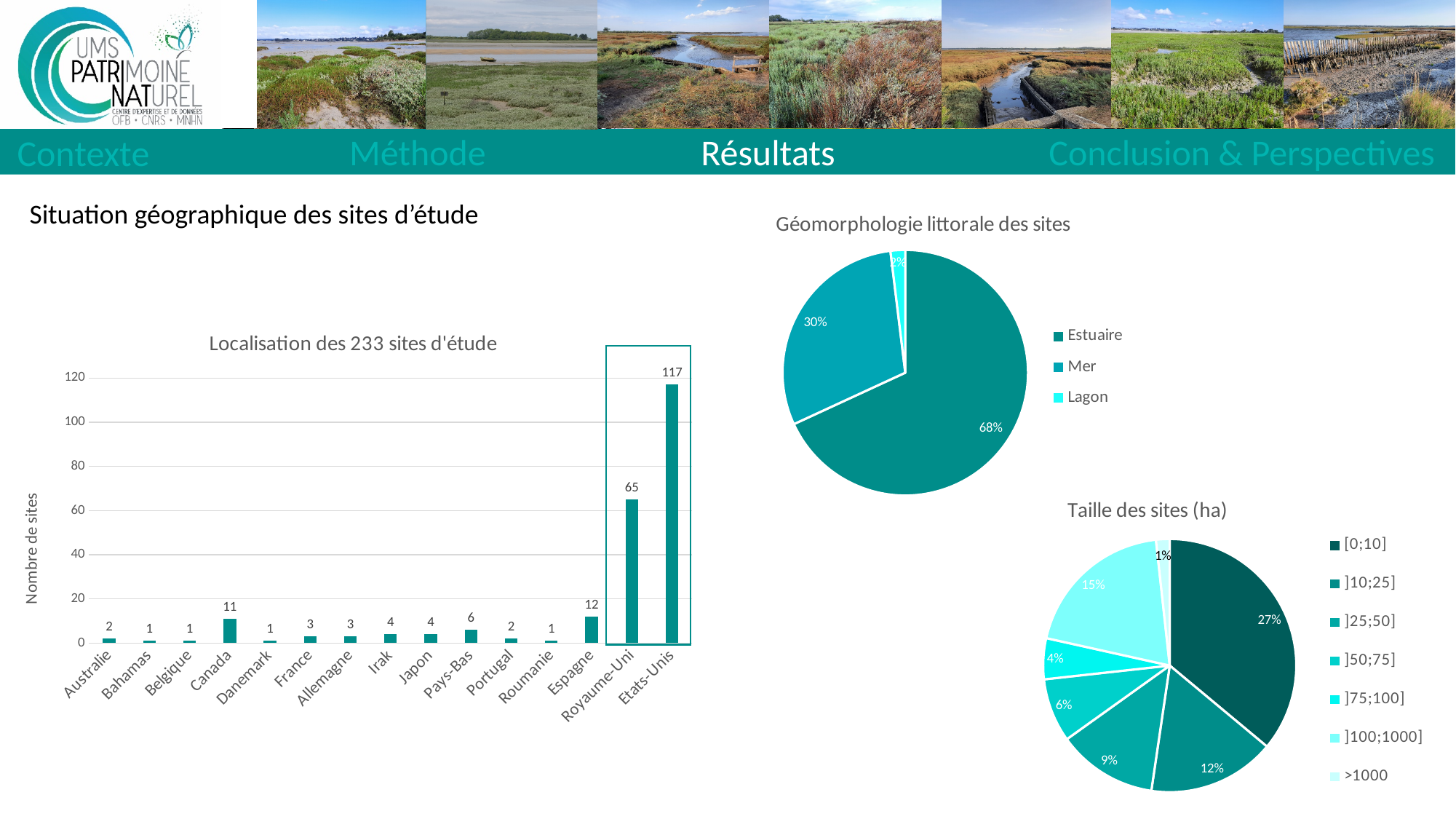
In the pie chart 'Géomorphologie littorale des sites', what share of sites is Estuaire? 68% In the pie chart 'Géomorphologie littorale des sites', what share of sites is Mer? 30% In the pie chart 'Taille des sites (ha)', what share of sites falls in the ]100;1000] category? 15% In the chart 'Localisation des 233 sites d'étude', which country has the most sites? Etats-Unis In the chart 'Localisation des 233 sites d'étude', how many sites are located in Etats-Unis? 117 How many countries are shown in the chart 'Localisation des 233 sites d'étude'? 15 In the chart 'Localisation des 233 sites d'étude', how many sites are located in Canada? 11 In the chart 'Localisation des 233 sites d'étude', which has more sites, Espagne or Canada? Espagne In the chart 'Localisation des 233 sites d'étude', what is the difference between the number of sites in Etats-Unis and in Royaume-Uni? 52 What type of chart is 'Localisation des 233 sites d'étude'? Bar chart How many categories does the legend of the pie chart 'Taille des sites (ha)' list? 7 In the chart 'Localisation des 233 sites d'étude', how many sites are located in Royaume-Uni? 65